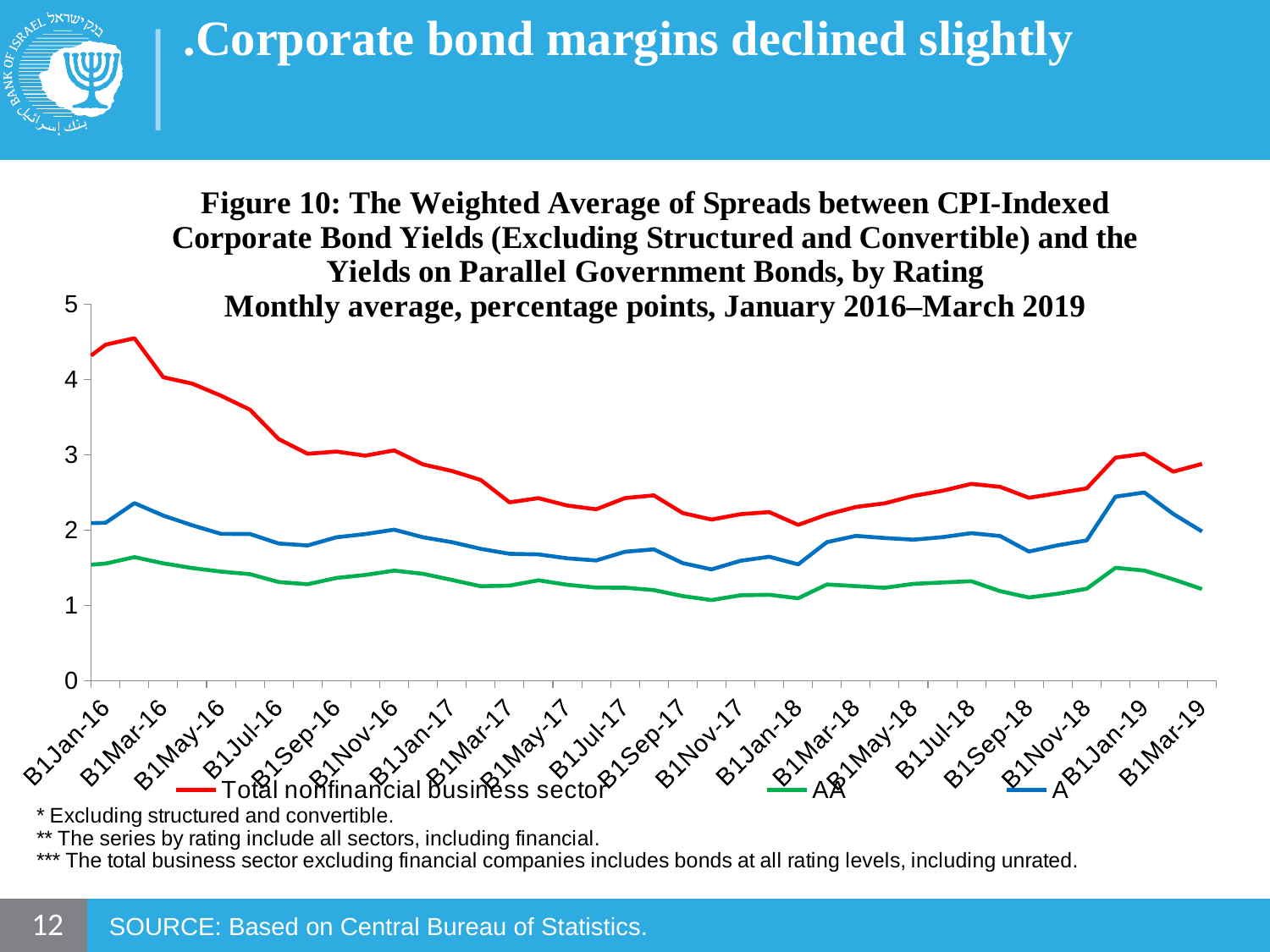
What is the first month shown on the x axis of the chart? Jan-16 What colour is the line for the AA series? Green Is the value for the A series at Jan-19 greater or less than 2? greater How many series does the legend list? 3 Is the value for the Total nonfinancial business sector series at Jan-16 greater or less than 4? greater Does the Total nonfinancial business sector series rise or fall between Jan-16 and Jan-18? Fall Is the value for the Total nonfinancial business sector series at Mar-19 greater or less than 3? less What kind of chart is shown on the slide? Line chart Which series has the highest values throughout the chart? Total nonfinancial business sector Which series has the lowest values throughout the chart? AA At Jan-16, which is larger: the value for the A series or the value for the AA series? A